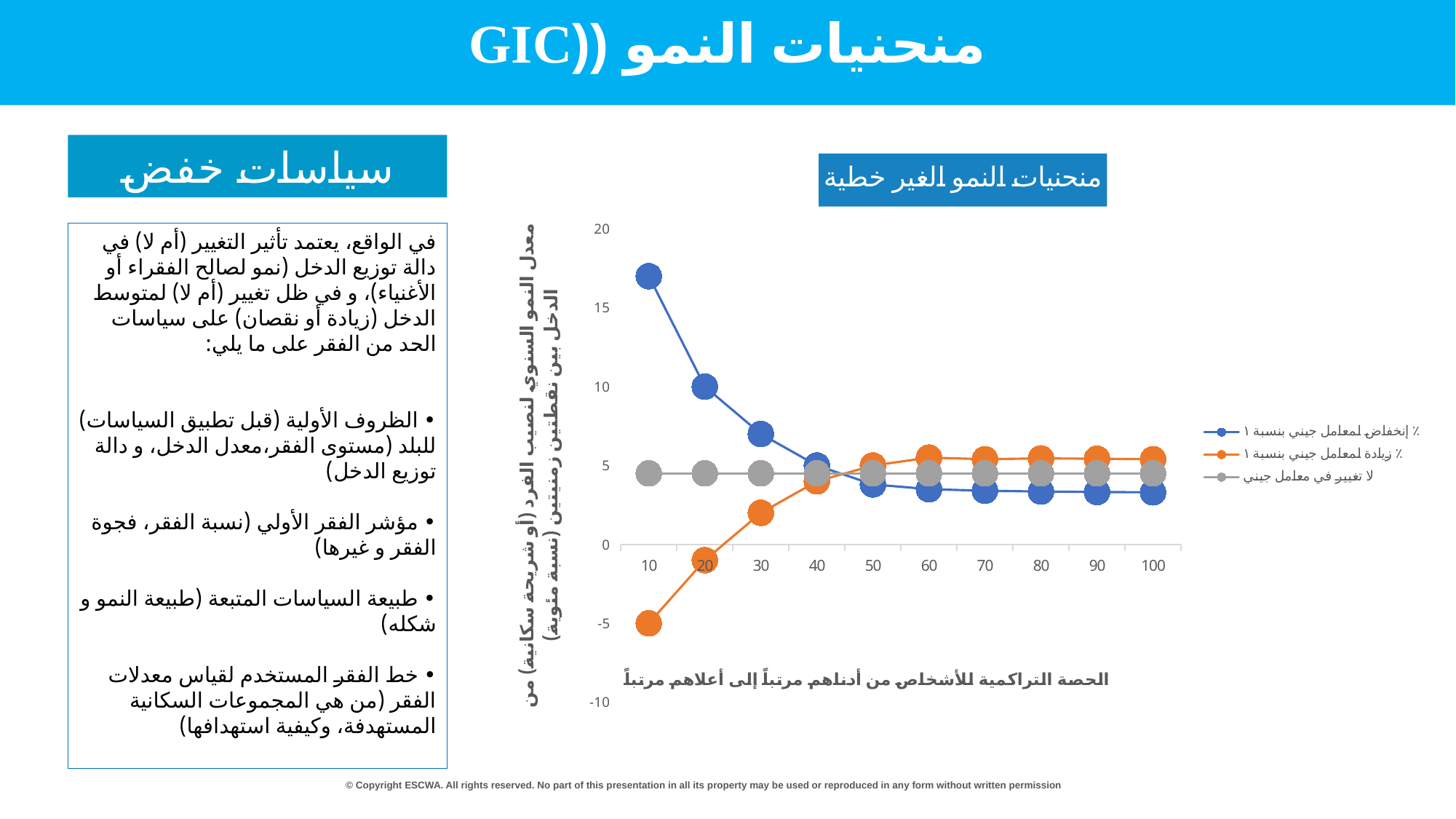
At which x-axis value is the blue series (إنخفاض لمعامل جيني بنسبة ١٪) highest? 10 At x = 10, which series is larger, the blue series or the orange series? the blue series Does the orange series (زيادة لمعامل جيني بنسبة ١٪) rise or fall as the x axis goes from 10 to 100? rise What is the title of the chart? منحنيات النمو الغير خطية At which x-axis value is the orange series (زيادة لمعامل جيني بنسبة ١٪) lowest? 10 Does the blue series (إنخفاض لمعامل جيني بنسبة ١٪) rise or fall as the x axis goes from 10 to 100? fall Is the value of the orange series at x = 20 greater or less than 0? less How many points along the x axis does each series have? 10 What kind of chart is shown on the slide? line chart Is the value of the blue series at x = 10 greater or less than 15? greater How many series does the chart legend list? 3 Is the value of the gray series (لا تغيير في معامل جيني) at x = 50 greater or less than 10? less